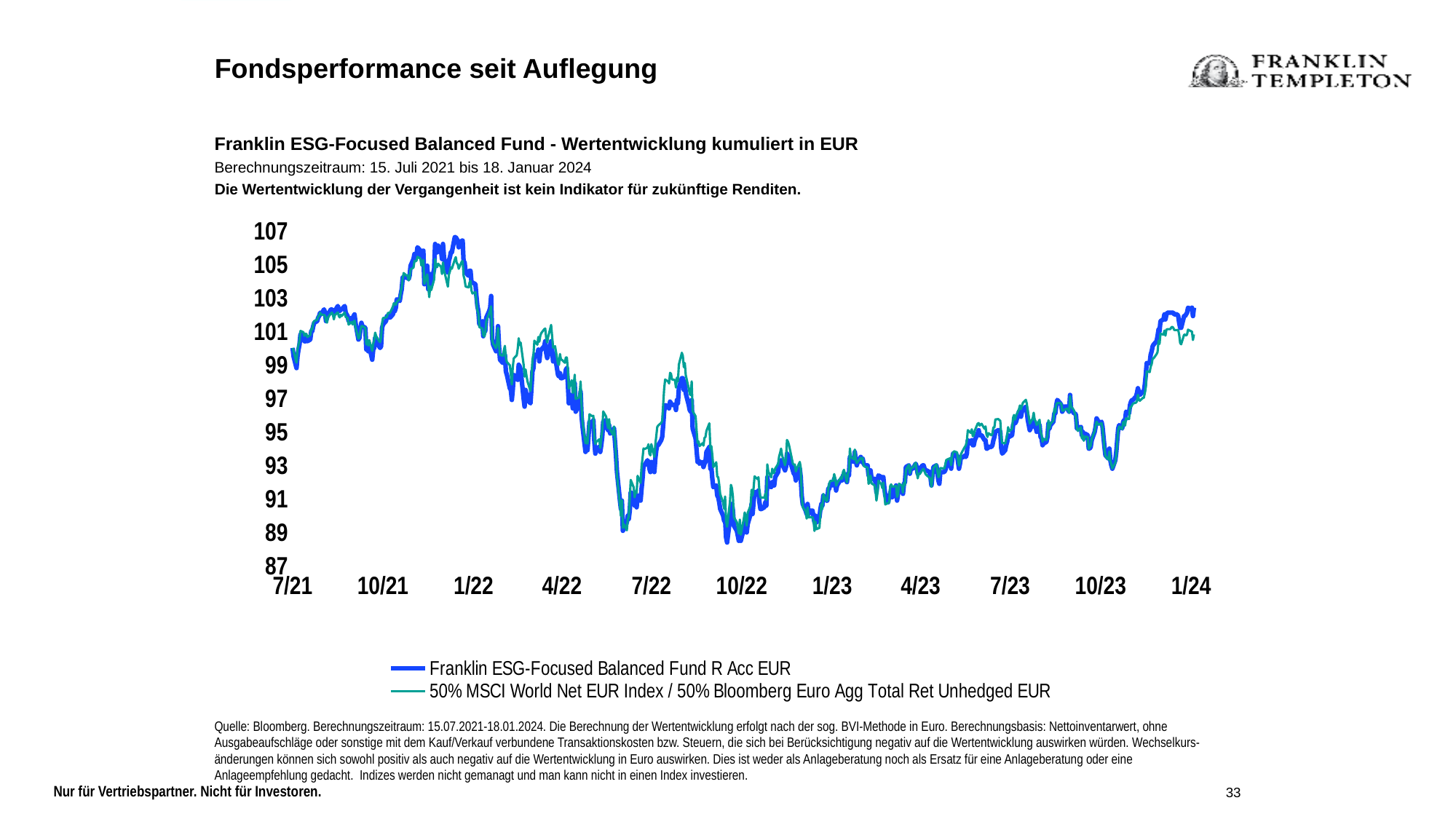
Is the value of the Franklin ESG-Focused Balanced Fund R Acc EUR line at 1/24 greater or less than 101? greater What kind of chart is shown on the slide? Line chart Do the values of the Franklin ESG-Focused Balanced Fund R Acc EUR line rise or fall between 10/23 and 1/24? rise How many series does the chart legend list? 2 How many date labels are shown on the x axis of the chart? 11 At the end of the chart (1/24), which series is higher: the Franklin ESG-Focused Balanced Fund R Acc EUR or the 50% MSCI World Net EUR Index / 50% Bloomberg Euro Agg Total Ret Unhedged EUR? Franklin ESG-Focused Balanced Fund R Acc EUR Is the value of the Franklin ESG-Focused Balanced Fund R Acc EUR line around 10/22 greater or less than 91? less What is the name of the benchmark series shown in green in the legend? 50% MSCI World Net EUR Index / 50% Bloomberg Euro Agg Total Ret Unhedged EUR Which series is drawn with the thick blue line? Franklin ESG-Focused Balanced Fund R Acc EUR Is the peak value of the Franklin ESG-Focused Balanced Fund R Acc EUR line around 1/22 greater or less than 105? greater Do the values of the Franklin ESG-Focused Balanced Fund R Acc EUR line rise or fall between 1/22 and 10/22? fall